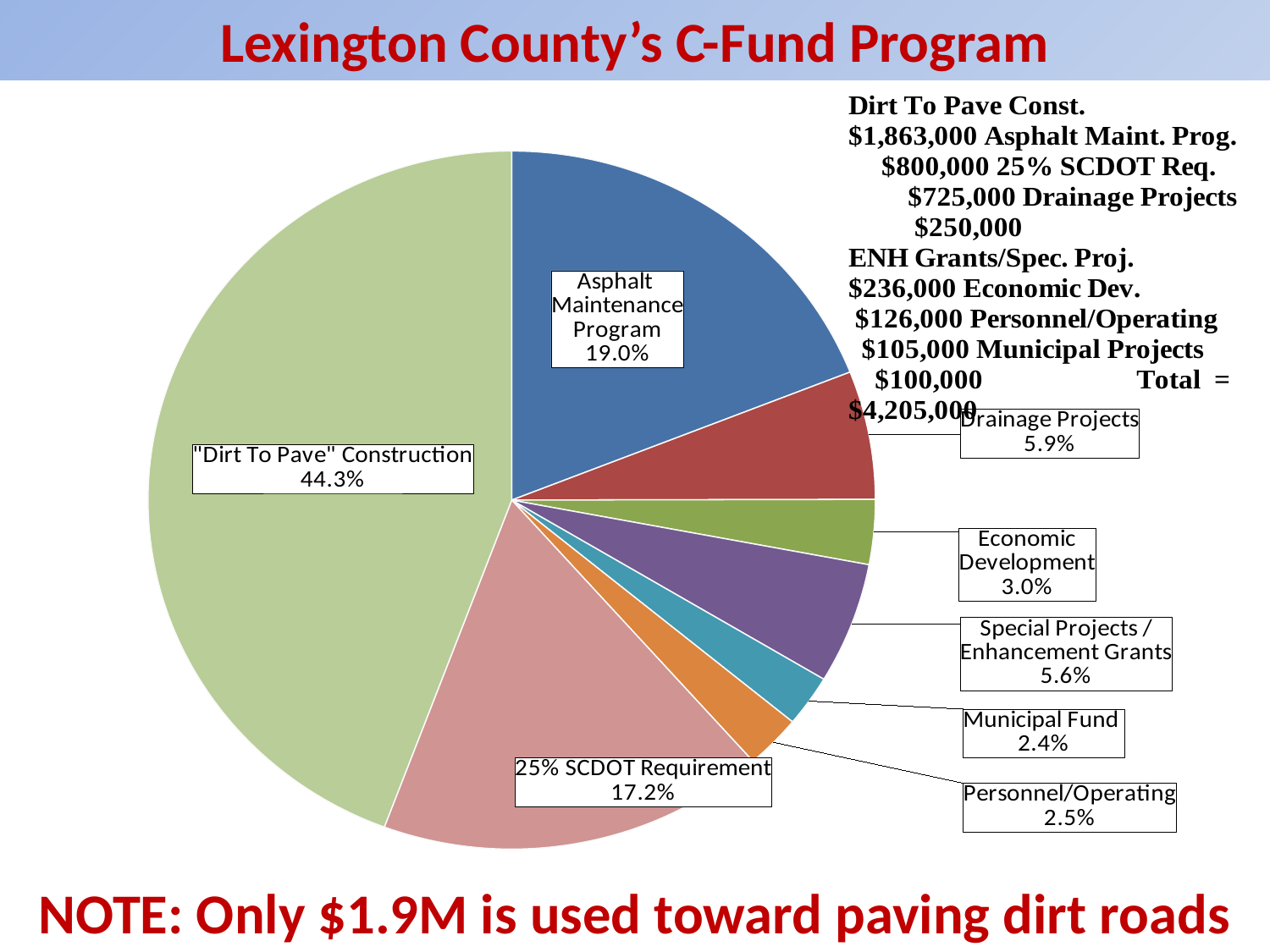
Which slice of the pie is the largest? "Dirt To Pave" Construction Which slice of the pie is the smallest? Municipal Fund What share of the pie does "Dirt To Pave" Construction represent? 44.3% What percentage is shown for Special Projects / Enhancement Grants? 5.6% What is the title of the slide containing the pie chart? Lexington County's C-Fund Program What kind of chart is shown on the slide? pie chart What percentage is shown for the Asphalt Maintenance Program slice? 19.0% What percentage is shown for the 25% SCDOT Requirement slice? 17.2% Which is larger, the Asphalt Maintenance Program slice or the 25% SCDOT Requirement slice? Asphalt Maintenance Program How many slices does the pie chart have? 8 What percentage is shown for Drainage Projects? 5.9% What is the difference in percentage points between "Dirt To Pave" Construction and the Asphalt Maintenance Program? 25.3